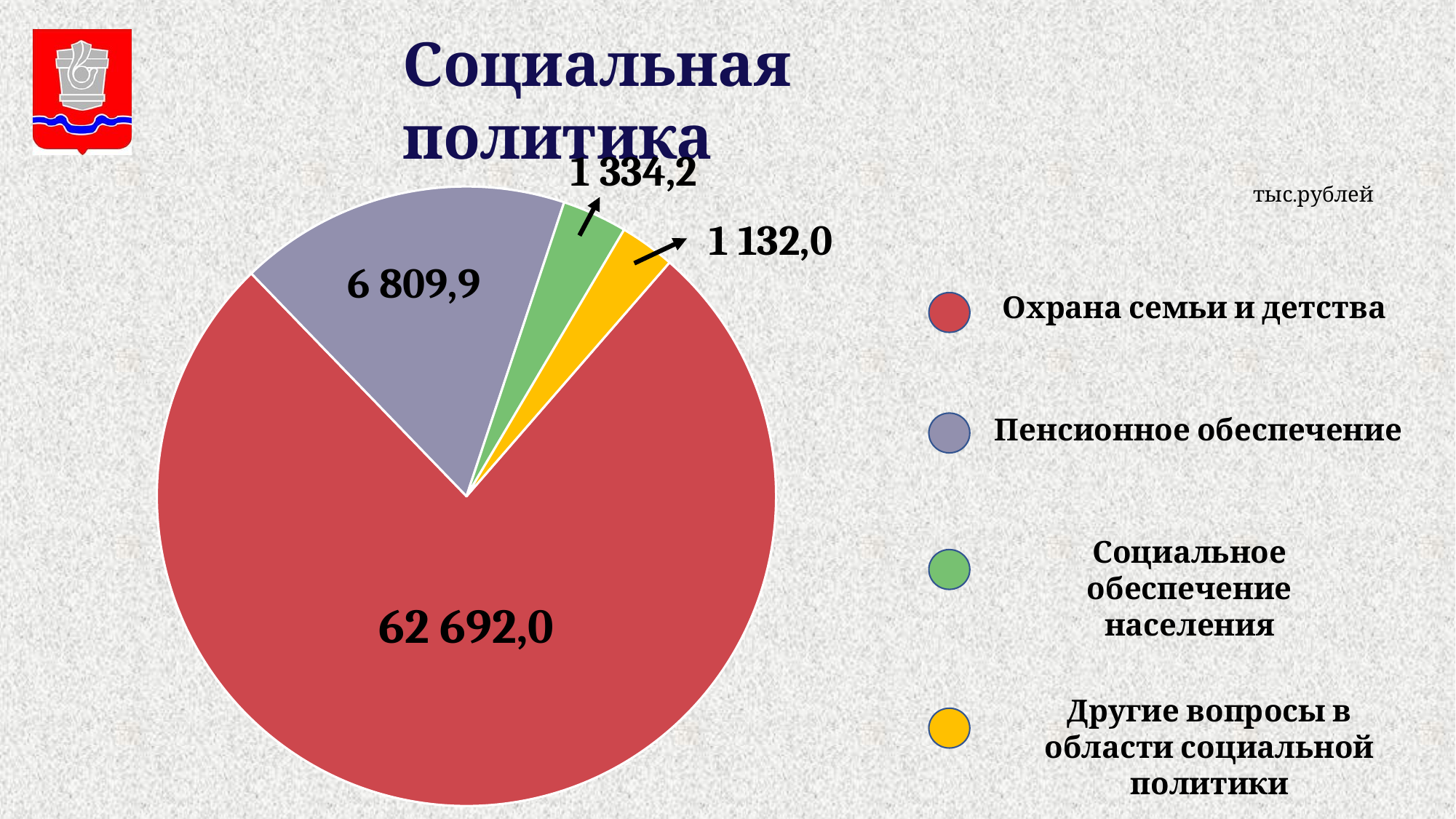
What is the difference between the values for Охрана семьи и детства and Пенсионное обеспечение? 55 882,1 What is the value for Социальное обеспечение населения? 1 334,2 What is the value for Другие вопросы в области социальной политики? 1 132,0 What type of chart is shown on the slide? Pie chart What is the difference between the values for Социальное обеспечение населения and Другие вопросы в области социальной политики? 202,2 What is the value for Пенсионное обеспечение? 6 809,9 What unit is indicated for the values in the chart? тыс.рублей Which category has the smallest slice of the pie? Другие вопросы в области социальной политики Which is larger: Пенсионное обеспечение or Социальное обеспечение населения? Пенсионное обеспечение Which category has the largest slice of the pie? Охрана семьи и детства How many categories does the pie chart have? 4 What is the value for Охрана семьи и детства? 62 692,0